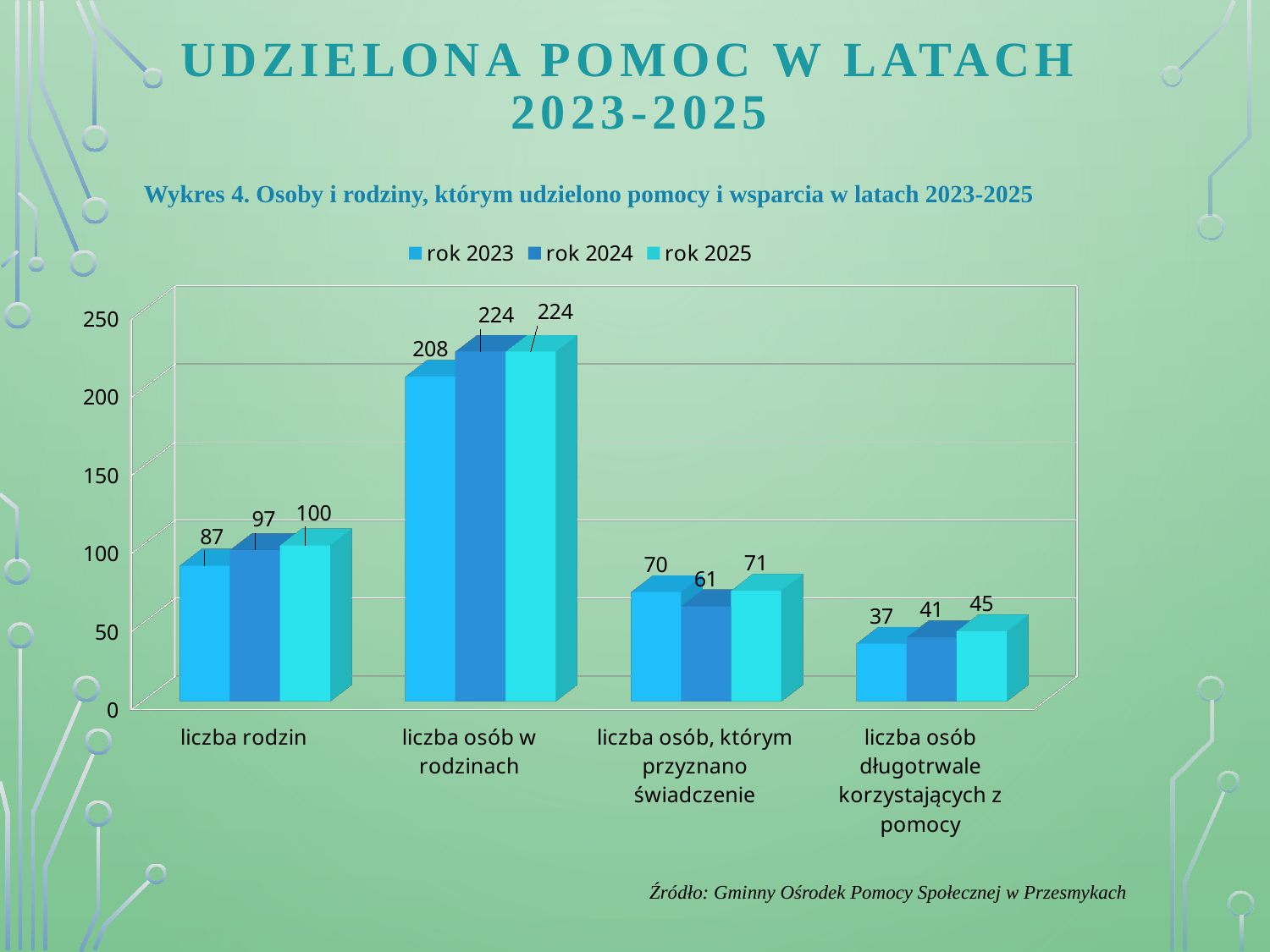
For 'liczba osób, którym przyznano świadczenie', which is larger: the 'rok 2023' value or the 'rok 2024' value? rok 2023 What is the difference between the 'rok 2025' and 'rok 2023' values for 'liczba rodzin'? 13 Which category has the highest value in the 'rok 2025' series? liczba osób w rodzinach What is the value for 'liczba rodzin' in the 'rok 2023' series? 87 How many categories are shown on the x axis? 4 What is the source given below the chart? Gminny Ośrodek Pomocy Społecznej w Przesmykach How many series does the legend list? 3 What kind of chart is shown on the slide? bar chart What is the value for 'liczba osób w rodzinach' in the 'rok 2024' series? 224 What is the value for 'liczba osób długotrwale korzystających z pomocy' in the 'rok 2025' series? 45 Is the 'rok 2023' value for 'liczba osób w rodzinach' greater or less than 200? greater Which category has the lowest value in the 'rok 2023' series? liczba osób długotrwale korzystających z pomocy